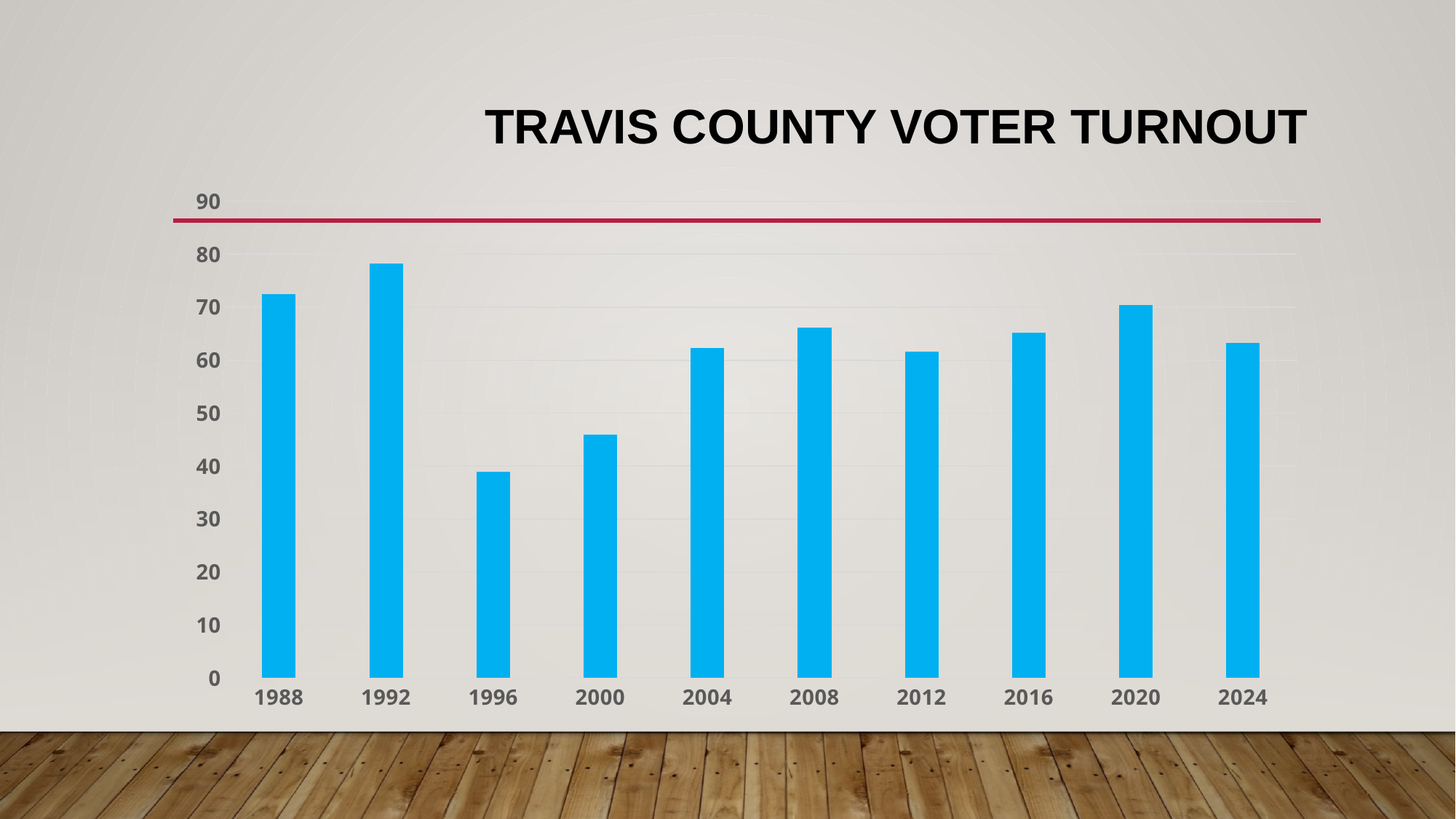
What kind of chart is shown on the slide? bar chart Which year has the lowest voter turnout? 1996 What is the title of the chart? Travis County Voter Turnout How many years are plotted on the x axis? 10 Which is larger, the value for 2020 or the value for 2024? 2020 Is the value for 1992 greater or less than 80? less Which year has the highest voter turnout? 1992 Is the value for 1996 greater or less than 40? less Does the voter turnout rise or fall from 1992 to 1996? fall Which is larger, the value for 2000 or the value for 2004? 2004 Is the value for 2000 greater or less than 50? less